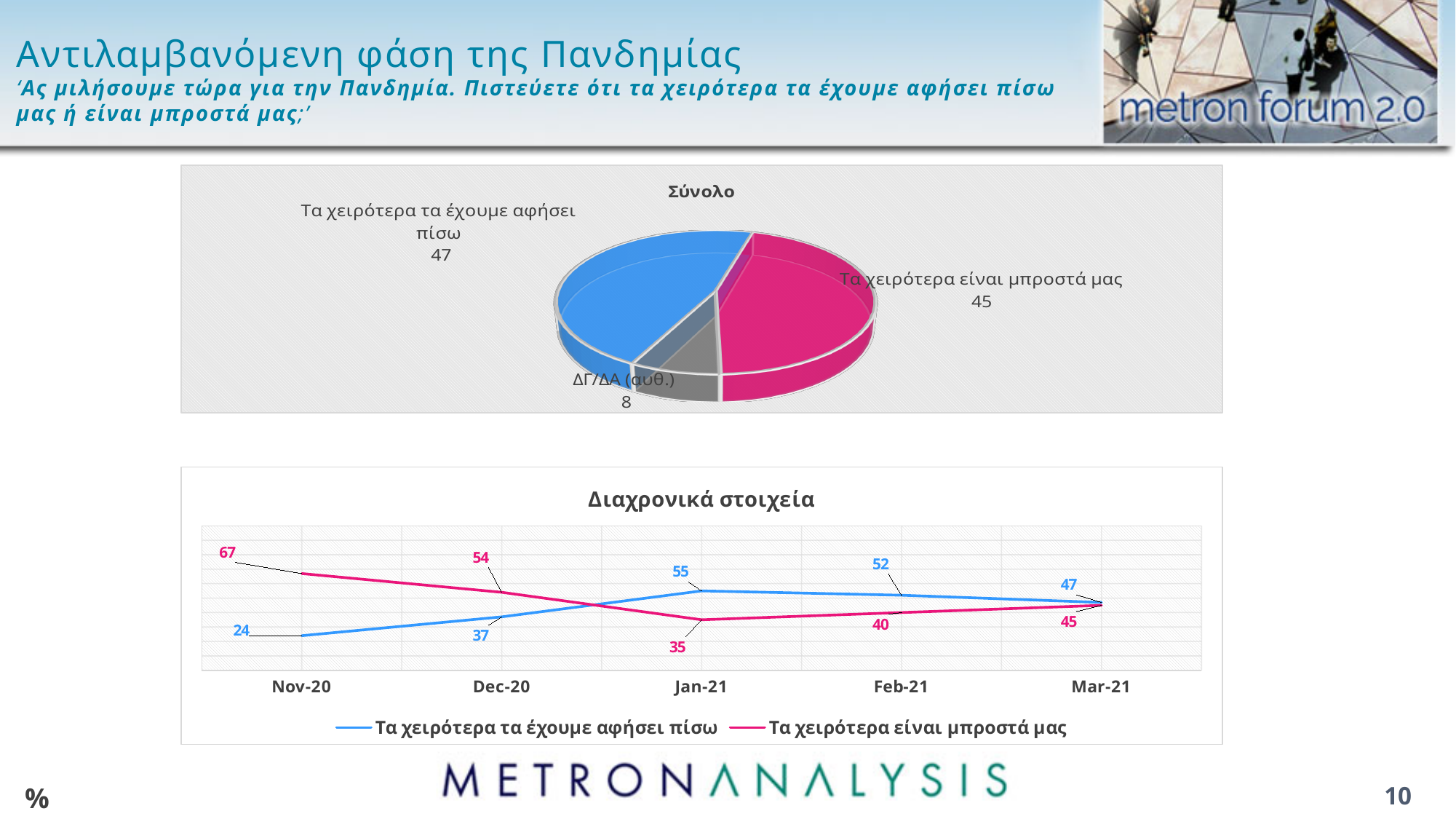
In the pie chart titled 'Σύνολο', what is the value for 'ΔΓ/ΔΑ (αυθ.)'? 8 In the chart titled 'Διαχρονικά στοιχεία', in which month does 'Τα χειρότερα τα έχουμε αφήσει πίσω' reach its highest value? Jan-21 In the pie chart titled 'Σύνολο', what is the value for 'Τα χειρότερα τα έχουμε αφήσει πίσω'? 47 In the chart titled 'Διαχρονικά στοιχεία', what is the value for 'Τα χειρότερα τα έχουμε αφήσει πίσω' in Jan-21? 55 In the pie chart titled 'Σύνολο', which slice is the smallest? ΔΓ/ΔΑ (αυθ.) In the pie chart titled 'Σύνολο', what is the difference between 'Τα χειρότερα τα έχουμε αφήσει πίσω' and 'Τα χειρότερα είναι μπροστά μας'? 2 In the chart titled 'Διαχρονικά στοιχεία', how many time points are shown on the x axis? 5 In the chart titled 'Διαχρονικά στοιχεία', what is the value for 'Τα χειρότερα είναι μπροστά μας' in Nov-20? 67 In the pie chart titled 'Σύνολο', how many slices are there? 3 In the chart titled 'Διαχρονικά στοιχεία', what is the difference between the two series in Dec-20? 17 In the chart titled 'Διαχρονικά στοιχεία', how many series does the legend list? 2 What kind of chart is the chart titled 'Διαχρονικά στοιχεία'? Line chart